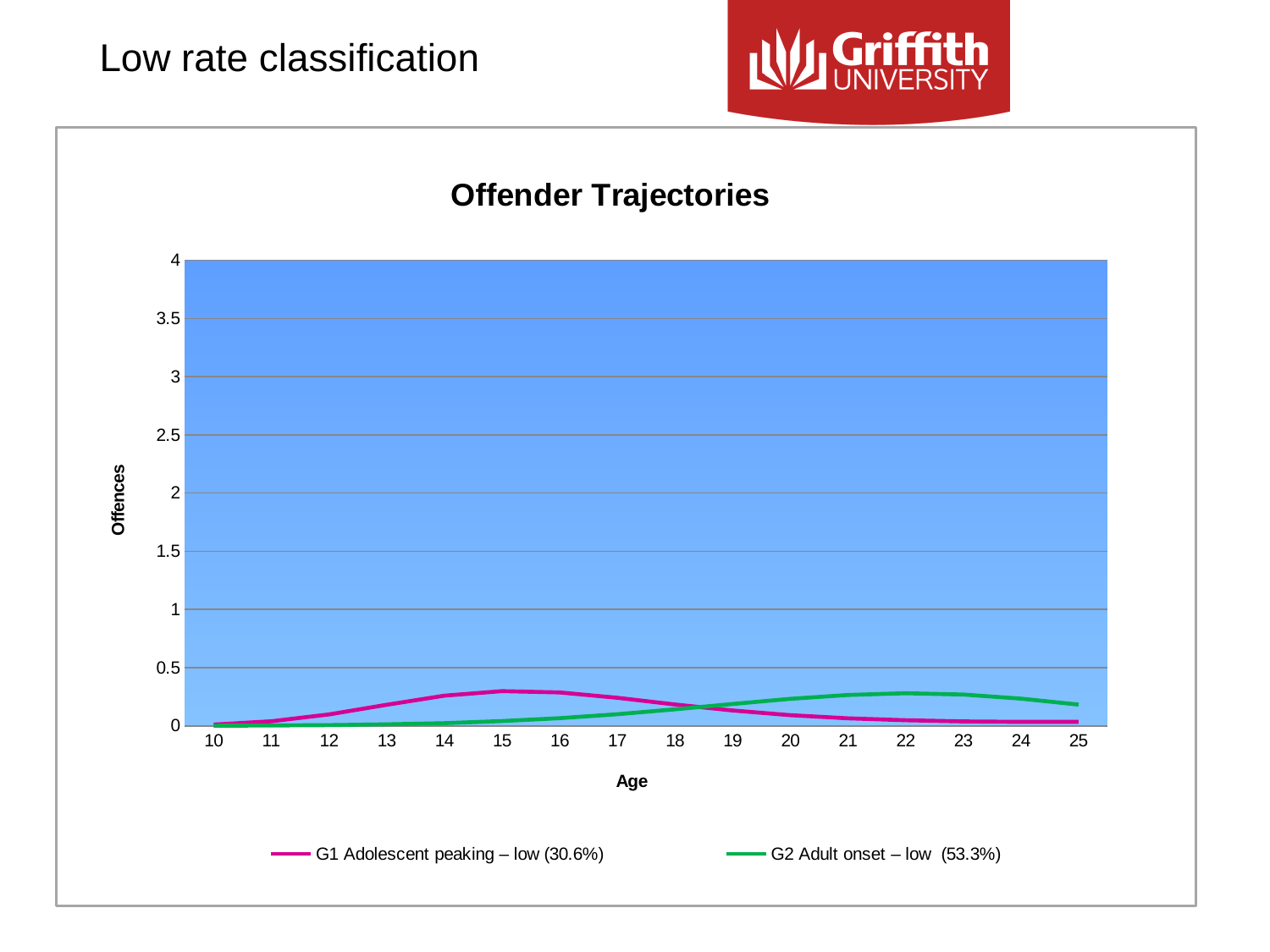
At which age does the G1 Adolescent peaking – low line reach its highest value? 15 What is the label of the y axis? Offences Is the value for G1 Adolescent peaking – low at age 15 greater or less than 0.5? less What is the title of the chart? Offender Trajectories At which age does the G2 Adult onset – low line reach its highest value? 22 At age 15, which series has the larger value, G1 Adolescent peaking – low or G2 Adult onset – low? G1 Adolescent peaking – low Is the value for G2 Adult onset – low at age 22 greater or less than 1? less How many age points are shown along the x axis? 16 What kind of chart is shown on the slide? line chart At age 22, which series has the larger value, G1 Adolescent peaking – low or G2 Adult onset – low? G2 Adult onset – low How many series does the legend list? 2 Does the G1 Adolescent peaking – low line rise or fall between age 15 and age 25? fall